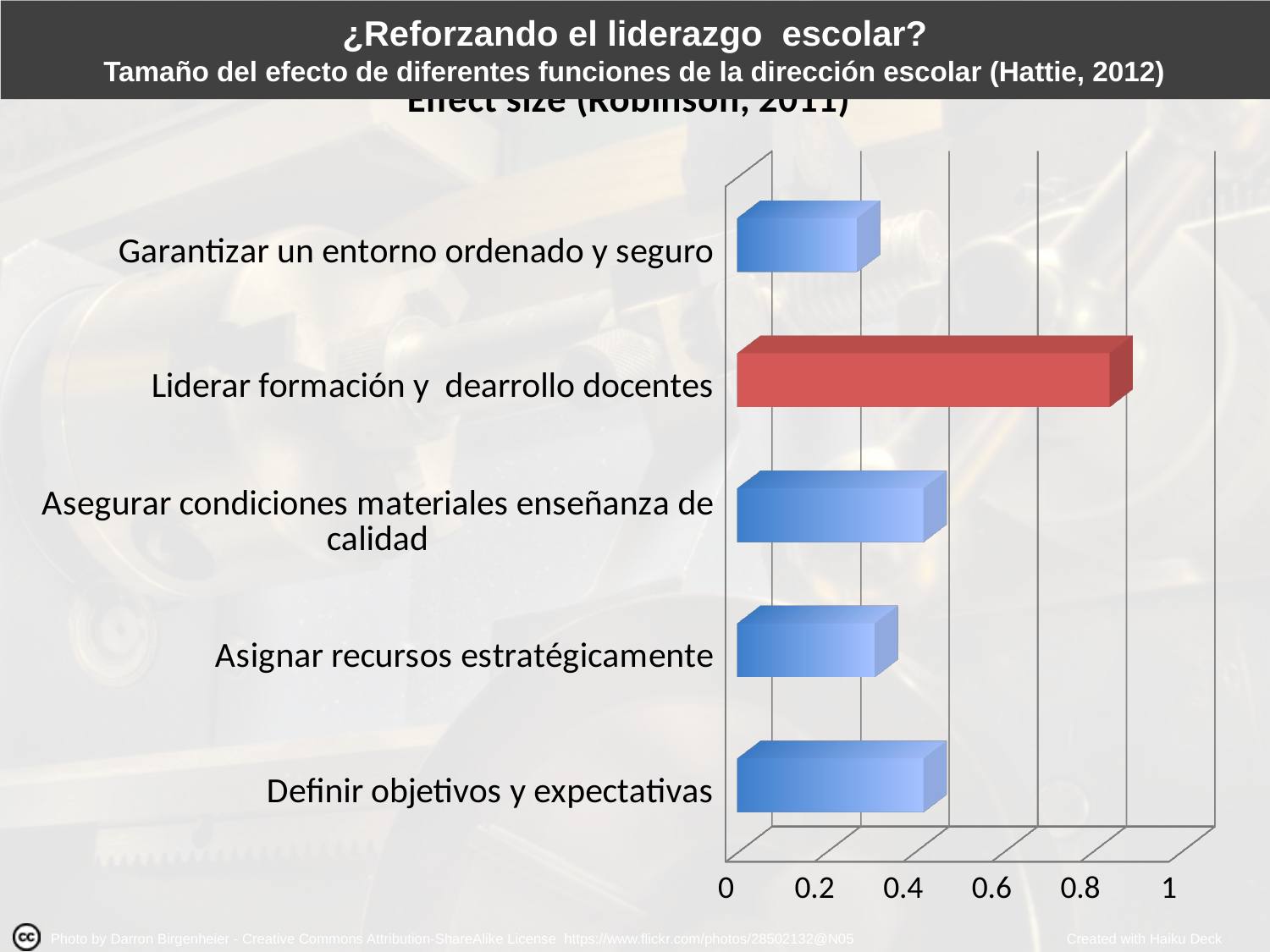
Which category's bar is coloured red instead of blue? Liderar formación y dearrollo docentes Is the value for Asegurar condiciones materiales enseñanza de calidad greater or less than 0.6? less Which is larger: the value for Liderar formación y dearrollo docentes or for Garantizar un entorno ordenado y seguro? Liderar formación y dearrollo docentes Is the value for Definir objetivos y expectativas greater or less than 0.6? less Is the value for Garantizar un entorno ordenado y seguro greater or less than 0.4? less What is the maximum value shown on the horizontal axis? 1 What kind of chart is shown on the slide? bar chart Which is larger: the value for Asegurar condiciones materiales enseñanza de calidad or for Asignar recursos estratégicamente? Asegurar condiciones materiales enseñanza de calidad How many categories (bars) does the chart show? 5 Which category has the highest effect size? Liderar formación y dearrollo docentes